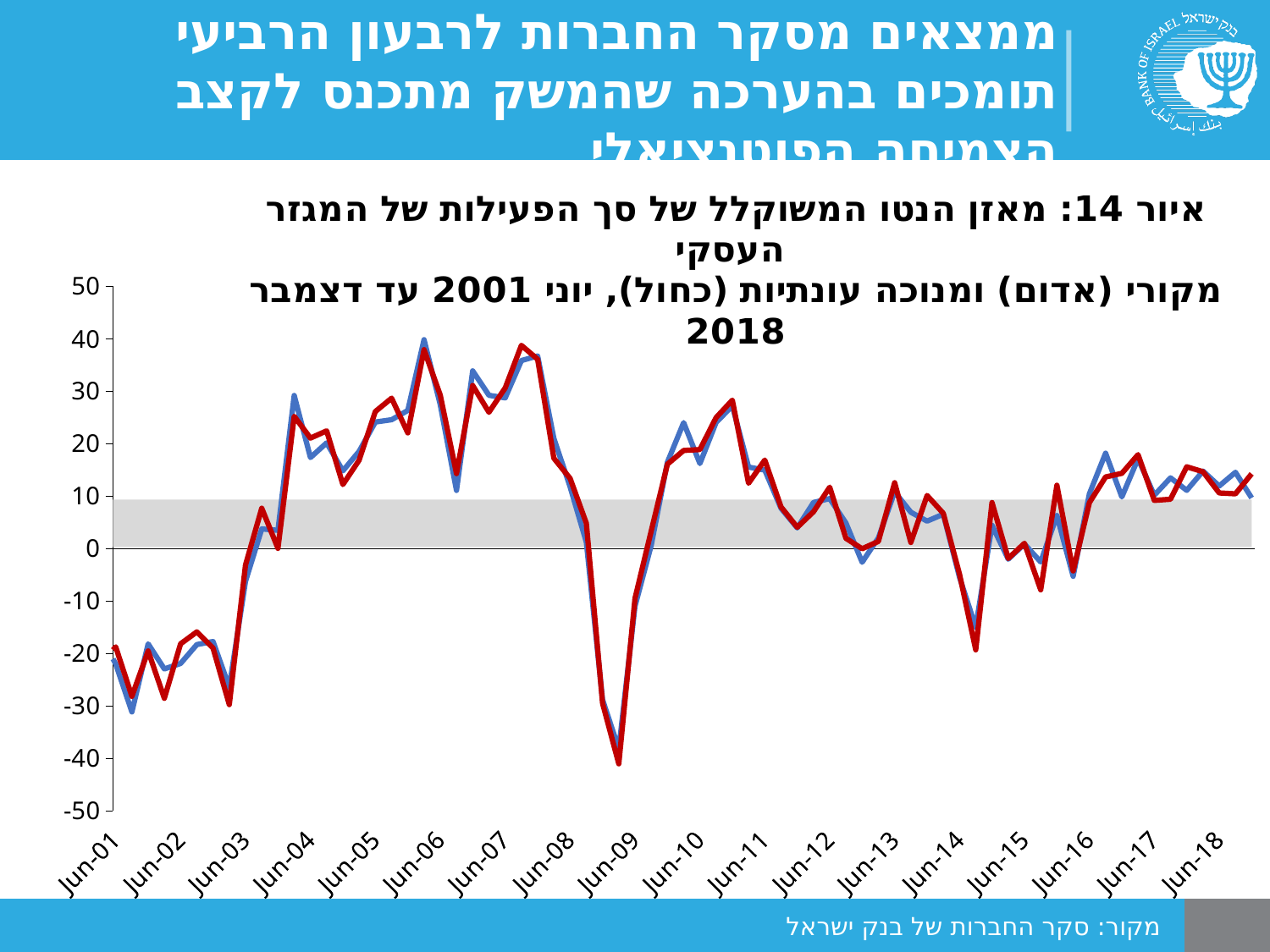
Which is larger for the red line: the value at Jun-04 or the value at Jun-01? Jun-04 What kind of chart is shown on the slide? line chart What is the highest value shown on the y axis of the chart? 50 Near which x-axis label does the red line reach its lowest value? Jun-09 How many lines (series) are plotted on the chart? 2 Is the value of the red line at Jun-01 greater or less than 0? less Do the values of the red line rise or fall between Jun-08 and Jun-09? fall How many labels are shown on the x axis of the chart? 18